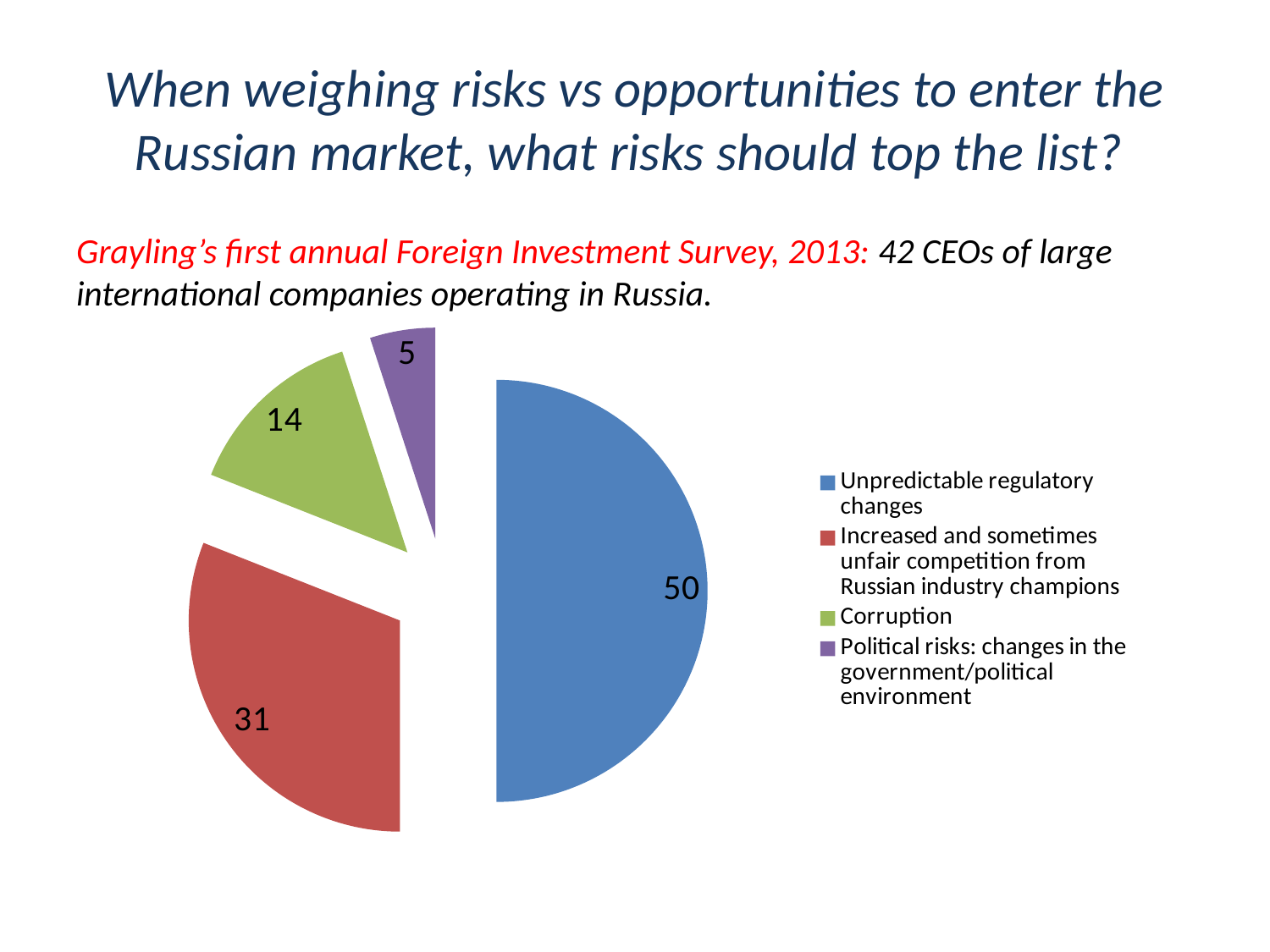
What is the difference between the values for Unpredictable regulatory changes and Corruption? 36 What is the value for Unpredictable regulatory changes? 50 Which category has the largest slice of the pie? Unpredictable regulatory changes What colour is the slice for Corruption? green What is the value for Corruption? 14 What share of the pie does the Corruption slice represent? 14% Which is larger, the value for Corruption or the value for Increased and sometimes unfair competition from Russian industry champions? Increased and sometimes unfair competition from Russian industry champions How many categories does the pie chart show? 4 What type of chart is shown on the slide? pie chart Which category has the smallest slice of the pie? Political risks: changes in the government/political environment What is the value for Political risks: changes in the government/political environment? 5 What is the value for Increased and sometimes unfair competition from Russian industry champions? 31